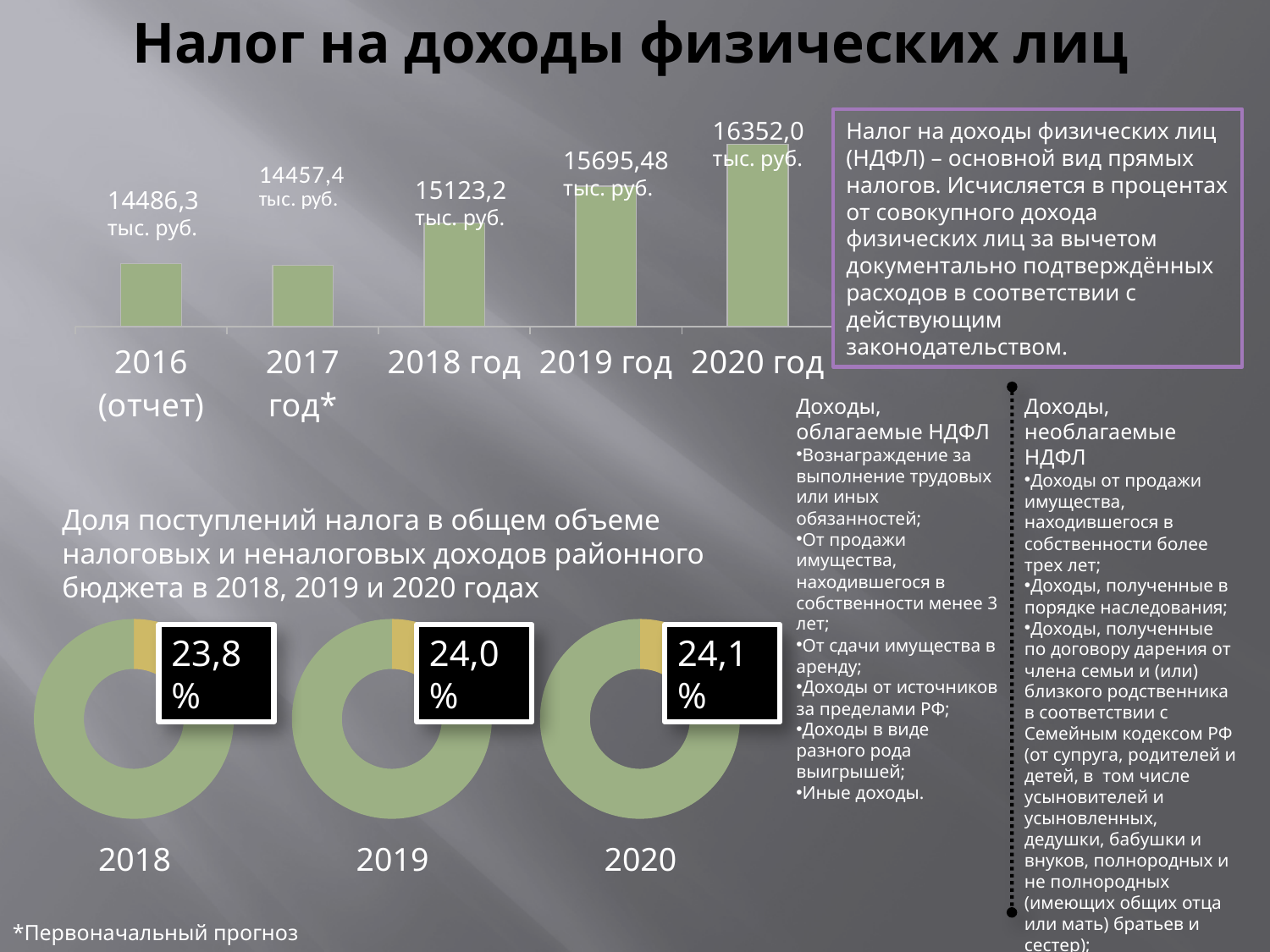
In the bar chart, which year has the lowest value? 2017 год* In the bar chart, what is the difference between the values for 2020 год and 2019 год? 656,52 тыс. руб. In the bar chart, what is the value for 2016 (отчет)? 14486,3 тыс. руб. In the bar chart, which year has the highest value? 2020 год In the bar chart, what is the difference between the values for 2018 год and 2016 (отчет)? 636,9 тыс. руб. In the donut charts at the bottom, which year shows the largest share: 2018 or 2020? 2020 In the bar chart, which is larger: the value for 2018 год or the value for 2017 год*? 2018 год In the bar chart, what is the value for 2019 год? 15695,48 тыс. руб. In the donut charts at the bottom, what share is shown for 2019? 24,0% How many bars are in the bar chart at the top of the slide? 5 What kind of chart is shown at the top of the slide? bar chart In the bar chart, do the values rise or fall from 2018 год to 2020 год? rise